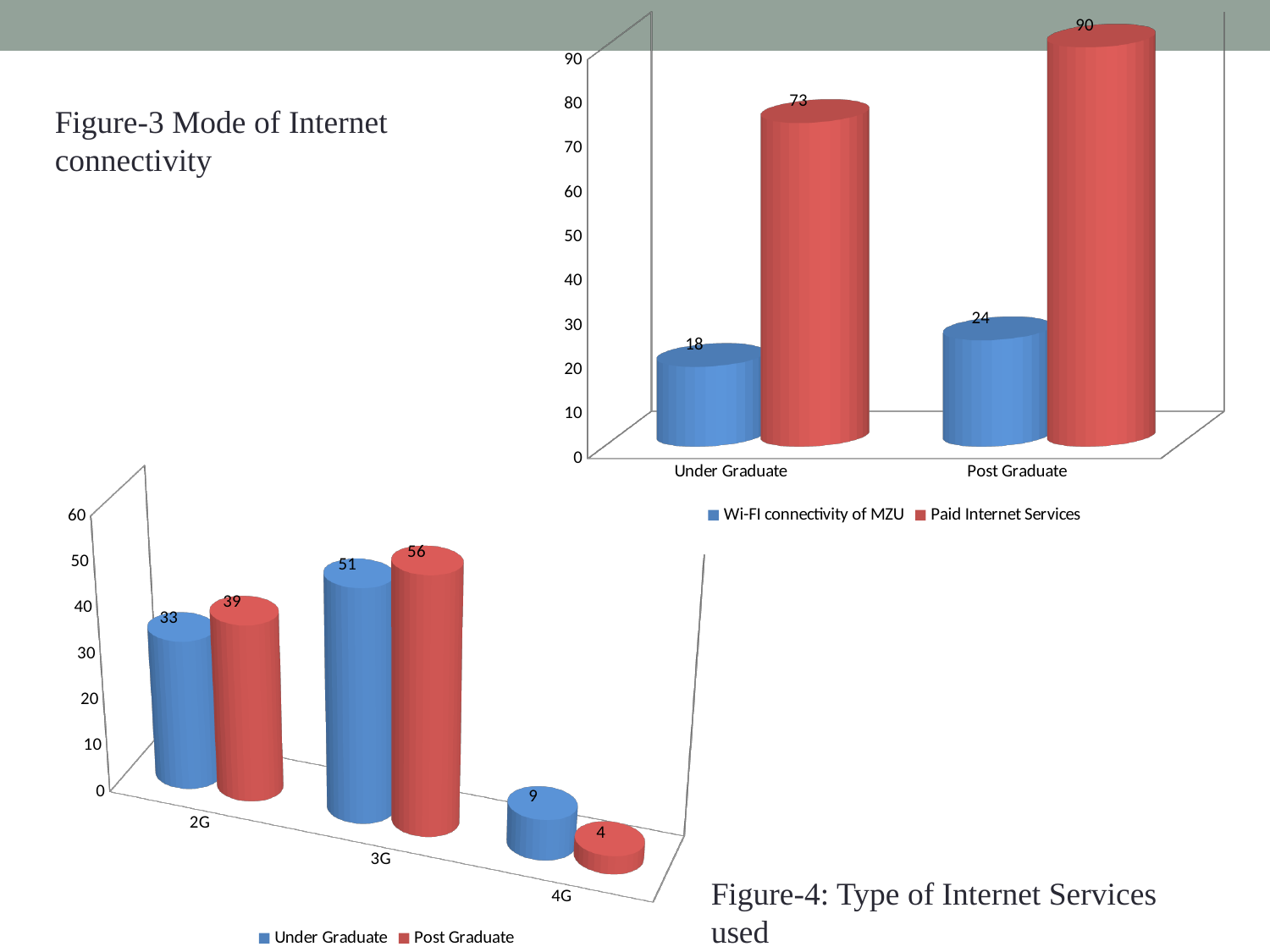
In the Figure-3 Mode of Internet connectivity chart, which colour represents Paid Internet Services? Red In the Figure-3 Mode of Internet connectivity chart, what is the value for Wi-FI connectivity of MZU among Post Graduate students? 24 In the Figure-4 Type of Internet Services used chart, which is larger for 2G: Under Graduate or Post Graduate? Post Graduate In the Figure-4 Type of Internet Services used chart, which category has the lowest value for Post Graduate? 4G In the Figure-4 Type of Internet Services used chart, how many categories are shown on the x axis? 3 In the Figure-3 Mode of Internet connectivity chart, which bar has the highest value? Paid Internet Services, Post Graduate In the Figure-3 Mode of Internet connectivity chart, what is the value for Paid Internet Services among Under Graduate students? 73 In the Figure-4 Type of Internet Services used chart, what is the value for Under Graduate students using 4G? 9 What kind of chart is the Figure-4 Type of Internet Services used chart? Bar chart In the Figure-3 Mode of Internet connectivity chart, how many series does the legend list? 2 In the Figure-4 Type of Internet Services used chart, what is the value for Post Graduate students using 3G? 56 In the Figure-3 Mode of Internet connectivity chart, what is the difference between Paid Internet Services and Wi-FI connectivity of MZU for Under Graduate students? 55